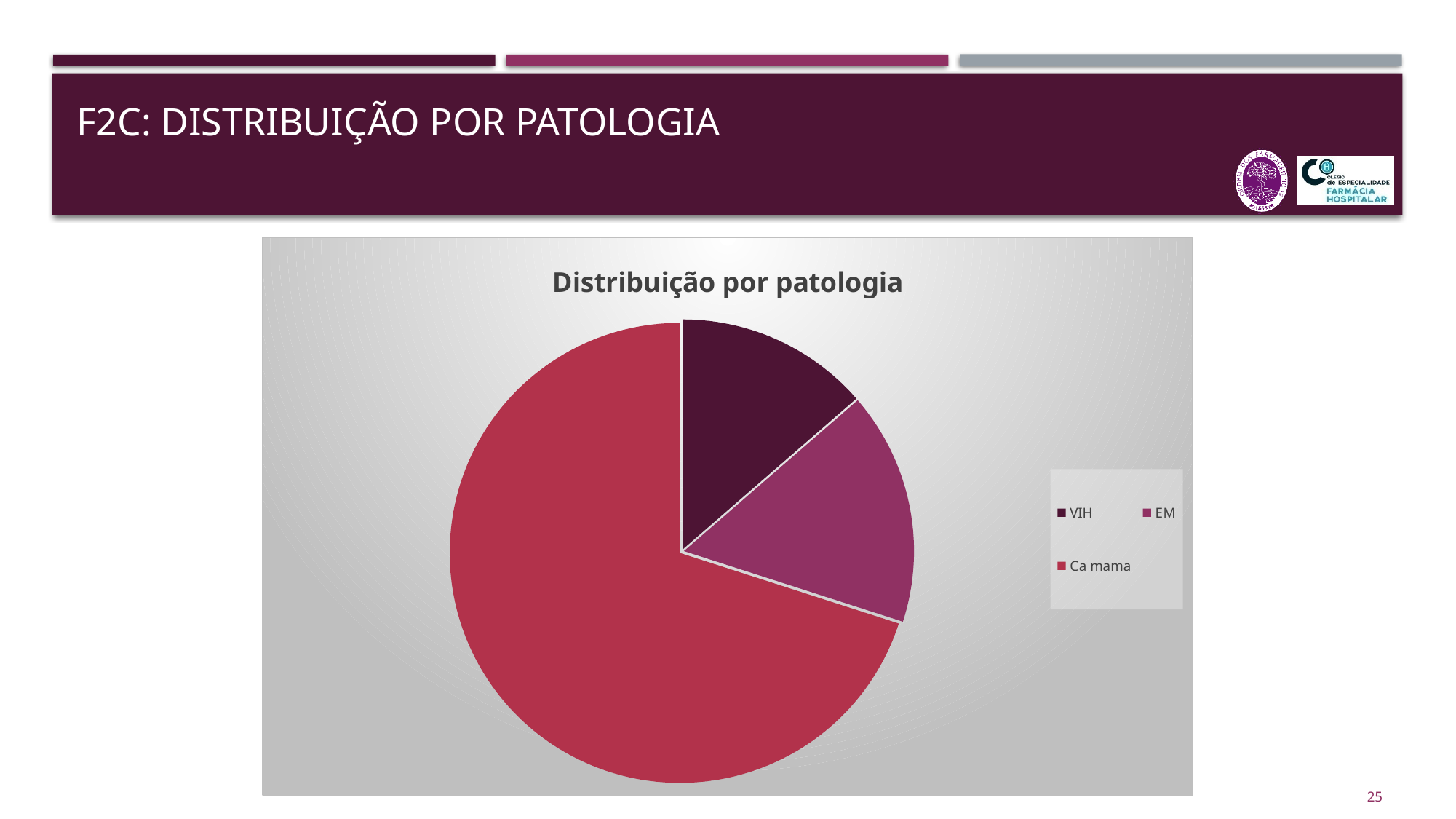
What is the title of the chart? Distribuição por patologia How many categories (slices) does the pie chart have? 3 What kind of chart is shown on the slide? pie chart Which is larger, the slice for Ca mama or the slice for EM? Ca mama Which is larger, the slice for Ca mama or the slice for VIH? Ca mama Which category has the largest slice of the pie? Ca mama Does the Ca mama slice account for more or less than half of the pie? more Which categories are listed in the chart legend? VIH, EM, Ca mama